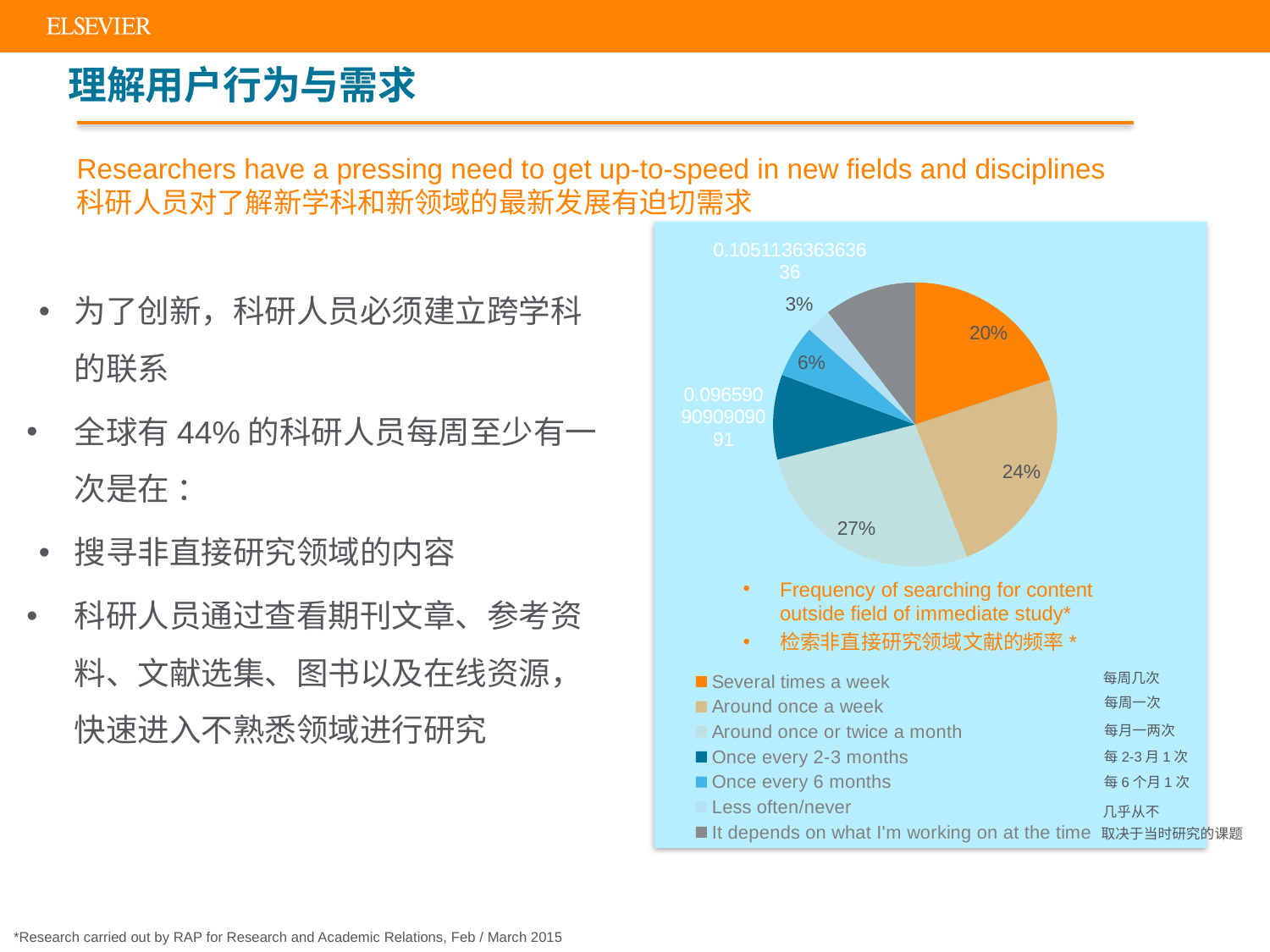
Which slice is larger: 'Several times a week' or 'Around once a week'? Around once a week What share of the pie is labelled for 'Once every 6 months'? 6% What share of the pie is labelled for 'Several times a week'? 20% What share of the pie is labelled for 'Around once a week'? 24% Which category has the largest slice of the pie? Around once or twice a month What share of the pie is labelled for 'Around once or twice a month'? 27% What kind of chart is shown on the slide? pie chart What is the English title of the pie chart? Frequency of searching for content outside field of immediate study* How many percentage points larger is the 'Around once or twice a month' slice than the 'Several times a week' slice? 7 How many categories does the legend of the pie chart list? 7 Which category has the smallest slice of the pie? Less often/never What share of the pie is labelled for 'Less often/never'? 3%